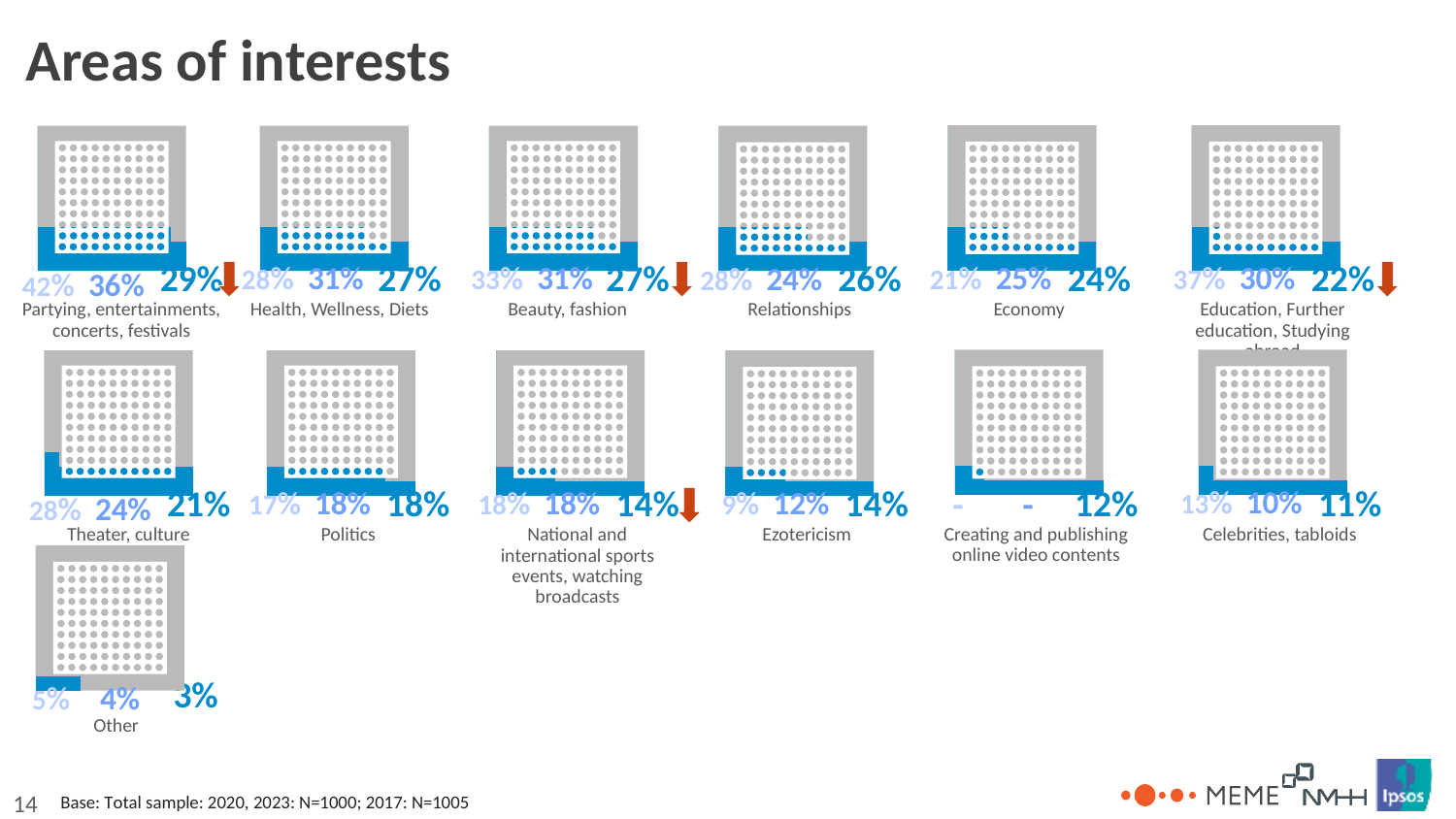
What three percentages are shown for Economy, from left to right? 21%, 25%, 24% Which area of interest has the highest rightmost (bold, dark blue) percentage? Partying, entertainments, concerts, festivals Which area of interest shows dashes instead of percentages for its first two values? Creating and publishing online video contents What is the rightmost (bold, dark blue) percentage shown for Partying, entertainments, concerts, festivals? 29% How many areas of interest are shown on the slide? 13 Which area of interest has the lowest rightmost (bold, dark blue) percentage? Other What is the rightmost (bold, dark blue) percentage shown for Ezotericism? 14% Which has the larger rightmost (bold, dark blue) percentage: Theater, culture or Politics? Theater, culture What three percentages are shown for Other, from left to right? 5%, 4%, 3% Do the three percentages for Partying, entertainments, concerts, festivals rise or fall from left to right? Fall How many areas of interest are marked with a red downward arrow? 4 What is the difference between the leftmost and rightmost percentages shown for Education, Further education, Studying abroad? 15 percentage points